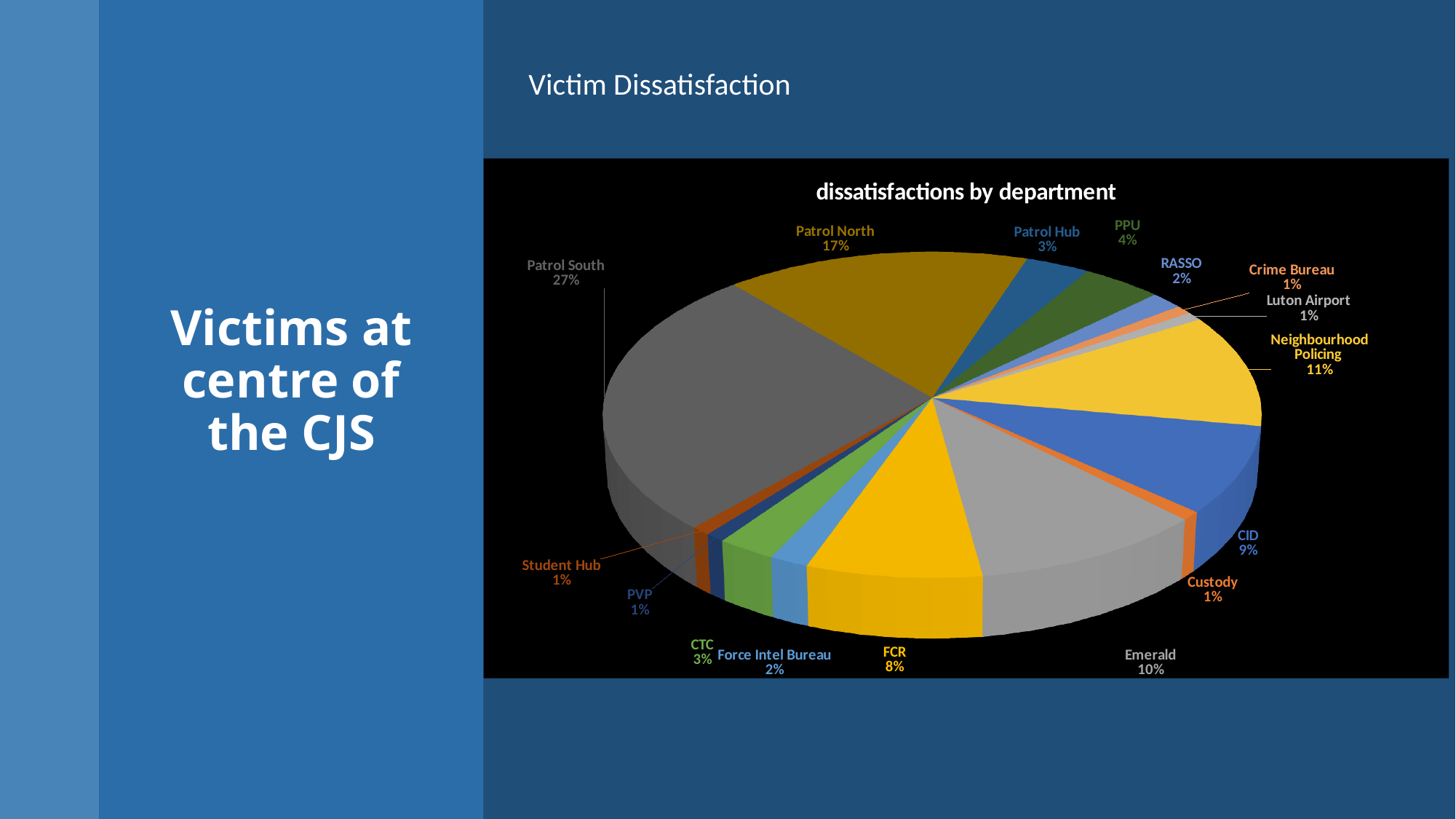
Which department has the largest share of dissatisfactions? Patrol South What percentage is shown for Neighbourhood Policing? 11% How many departments are shown in the pie chart? 16 What type of chart is shown on the slide? Pie chart Which has a larger share, PPU or Patrol Hub? PPU What share of dissatisfactions does Patrol South account for? 27% What is the difference in percentage points between Patrol South and Patrol North? 10 What is the title of the chart? dissatisfactions by department What percentage is shown for Emerald? 10% What is the combined share of CID and Emerald? 19% Which has a larger share, CID or FCR? CID What percentage is shown for Force Intel Bureau? 2%